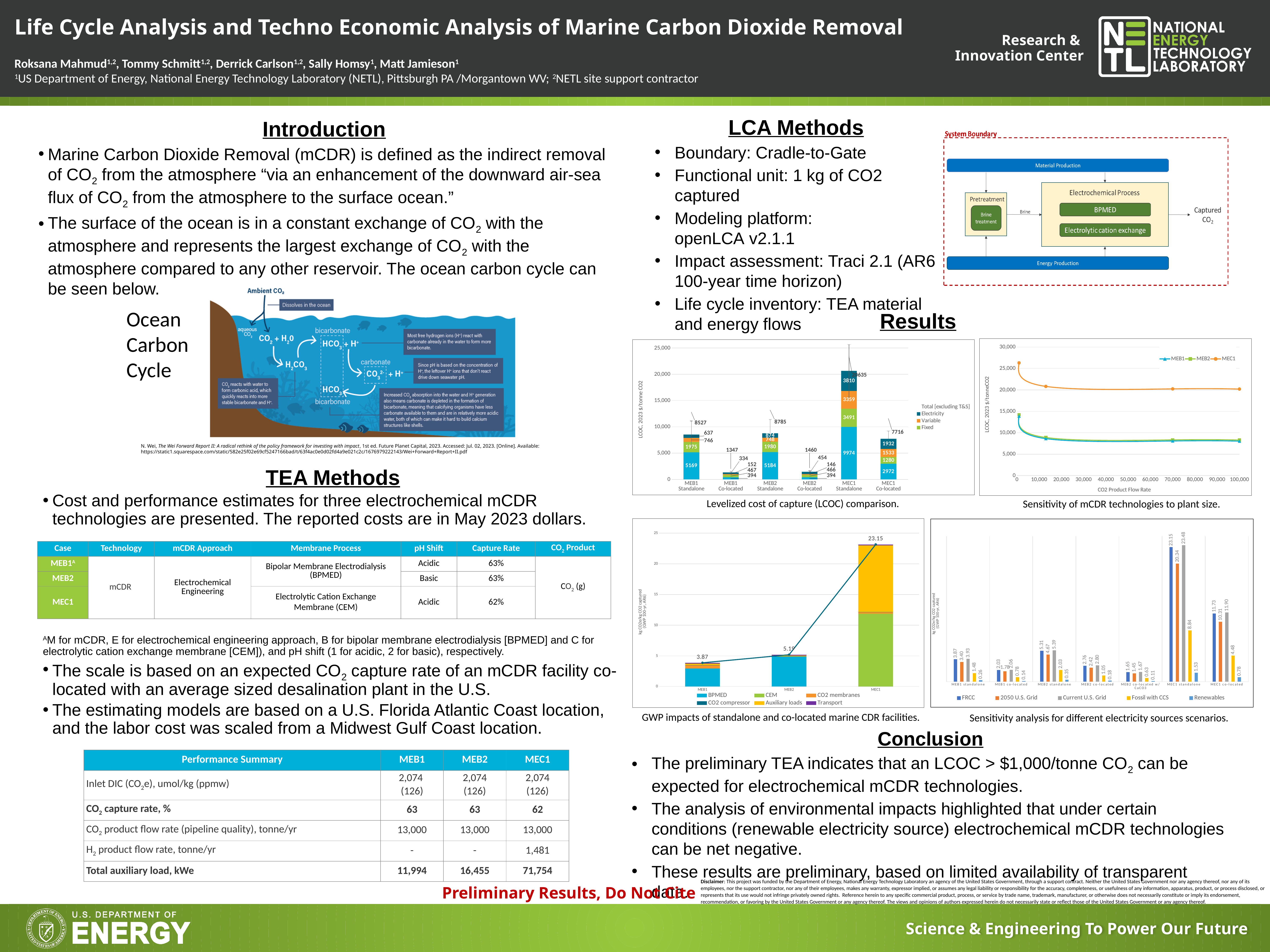
In the 'Sensitivity of mCDR technologies to plant size' chart, which technology has the highest LCOC across plant sizes? MEC1 In the 'Sensitivity of mCDR technologies to plant size' chart, do the LCOC values rise or fall as CO2 Product Flow Rate increases? fall In the 'Levelized cost of capture (LCOC) comparison' chart, what is the difference between the total LCOC of MEB2 Standalone and MEB1 Standalone? 258 In the 'Levelized cost of capture (LCOC) comparison' chart, what is the total LCOC for MEC1 Standalone? 20635 In the 'Levelized cost of capture (LCOC) comparison' chart, what is the Fixed cost value for MEC1 Standalone? 3491 In the 'GWP impacts of standalone and co-located marine CDR facilities' chart, what is the total value for MEC1? 23.15 In the 'Sensitivity analysis for different electricity sources scenarios' chart, how many electricity source scenarios does the legend list? 5 In the 'Levelized cost of capture (LCOC) comparison' chart, which case has the lowest total LCOC? MEB1 Co-located In the 'Sensitivity analysis for different electricity sources scenarios' chart, what is the value for MEC1 standalone under the Renewables scenario? 1.53 In the 'Sensitivity of mCDR technologies to plant size' chart, how many series does the legend list? 3 How many cases are shown on the x axis of the 'Levelized cost of capture (LCOC) comparison' chart? 6 In the 'GWP impacts of standalone and co-located marine CDR facilities' chart, what is the difference between the totals for MEB2 and MEB1? 1.32